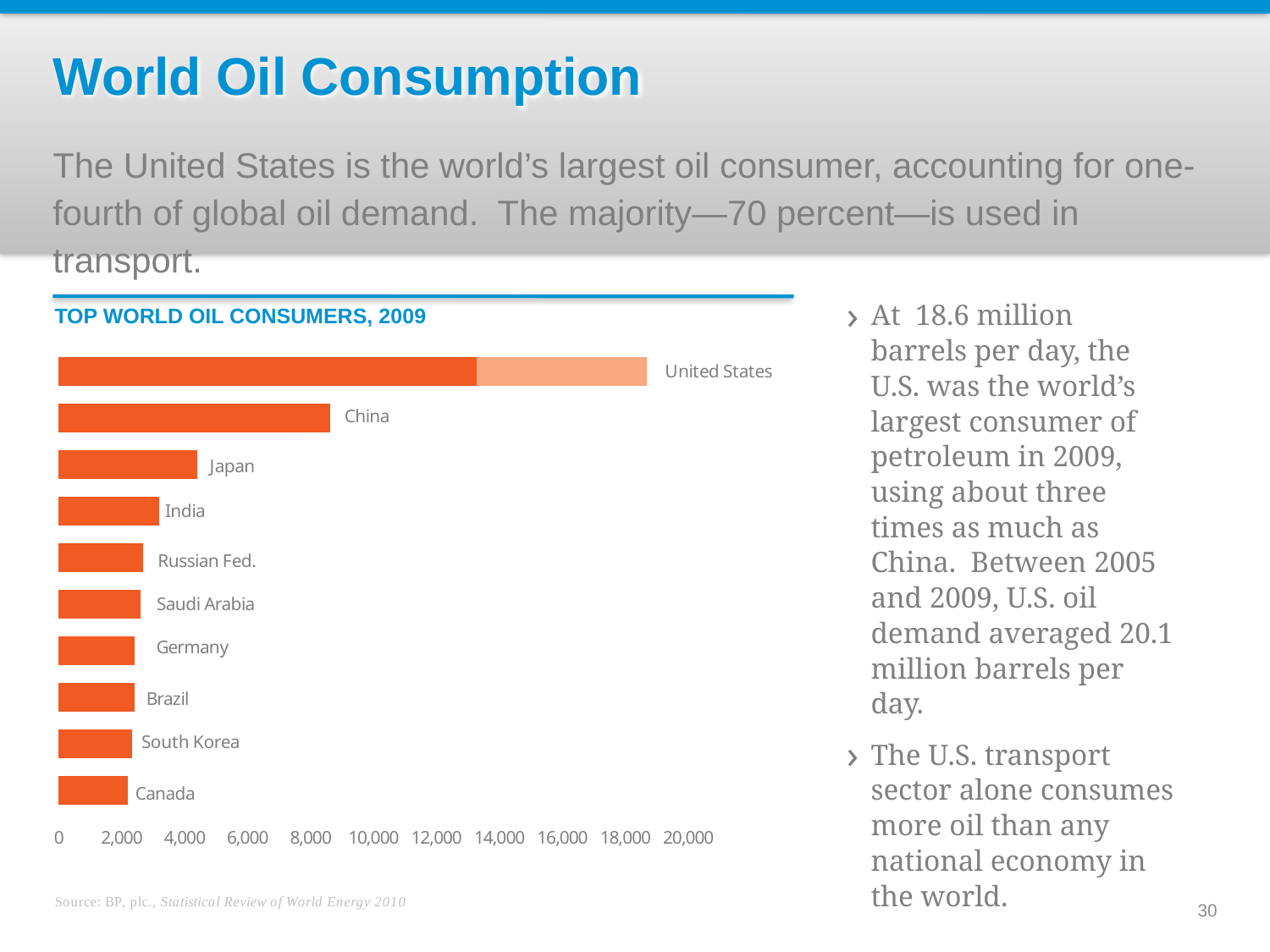
What kind of chart is shown on the slide? bar chart Is the value for Canada greater or less than 4,000? less How many countries are shown in the chart? 10 What is the title of the chart? TOP WORLD OIL CONSUMERS, 2009 Which is larger, the value for China or the value for Japan? China Which country has the second-longest bar in the chart? China Is the value for China greater or less than 10,000? less Is the value for India greater or less than 4,000? less Which country has the highest oil consumption in the chart? United States